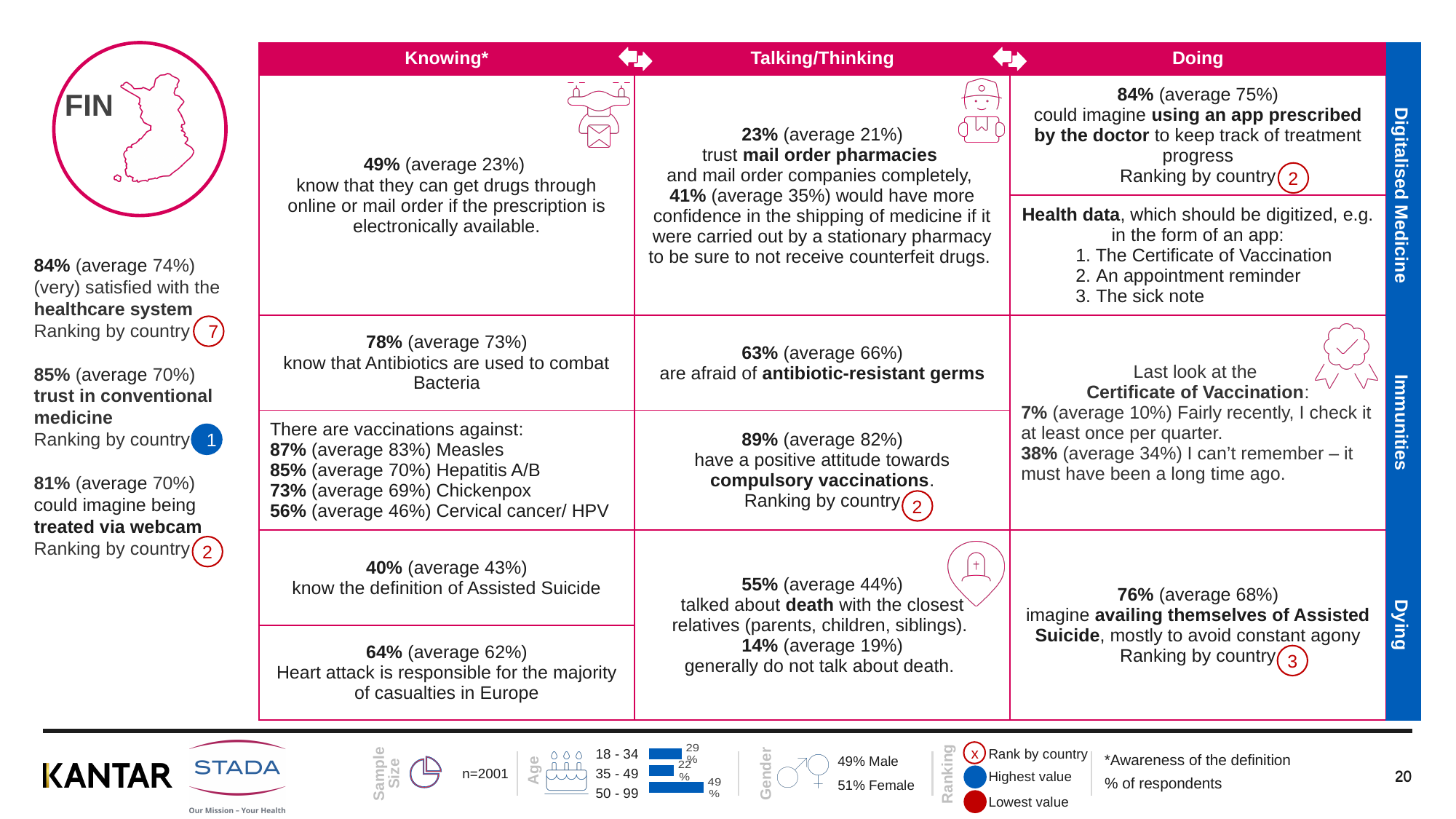
In the Age bar chart at the bottom of the slide, what is the difference between the 50 - 99 and 18 - 34 values? 20 percentage points In the Age bar chart at the bottom of the slide, what do the three values add up to? 100% What does the small bar chart at the bottom of the slide show? The age distribution of the sample In the Age bar chart at the bottom of the slide, what is the value for the 50 - 99 age group? 49% In the Age bar chart at the bottom of the slide, what is the difference between the 18 - 34 and 35 - 49 values? 7 percentage points In the Age bar chart at the bottom of the slide, what is the value for the 18 - 34 age group? 29% What kind of chart is the Age chart at the bottom of the slide? Bar chart In the Age bar chart at the bottom of the slide, how many age groups are shown? 3 In the Age bar chart at the bottom of the slide, which age group has the lowest value? 35 - 49 In the Age bar chart at the bottom of the slide, which age group has the highest value? 50 - 99 In the Age bar chart at the bottom of the slide, which is larger: the value for 18 - 34 or for 35 - 49? 18 - 34 In the Age bar chart at the bottom of the slide, what is the value for the 35 - 49 age group? 22%